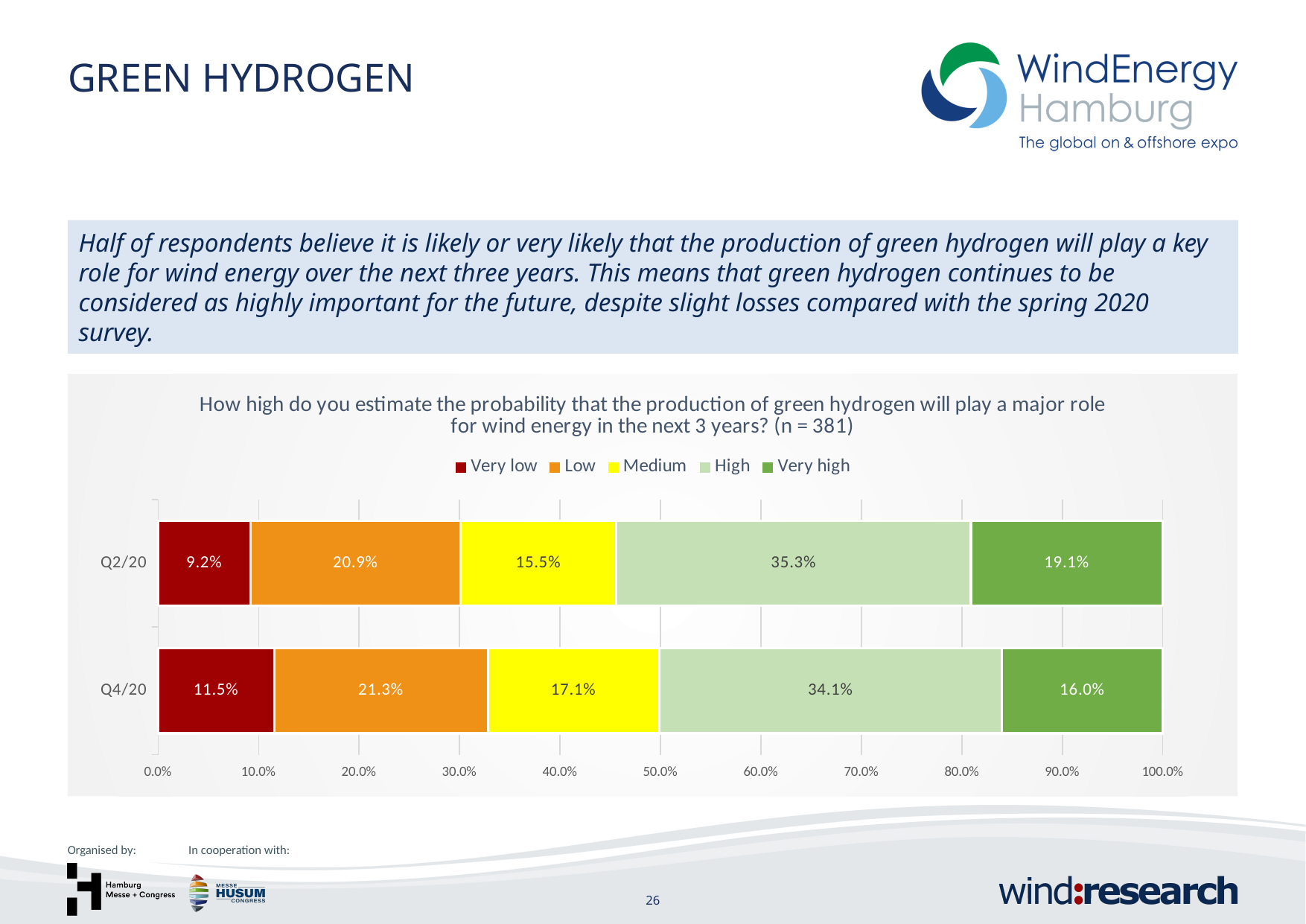
How many series does the legend list? 5 How many survey periods (bars) are shown in the chart? 2 By how many percentage points did the Very high share change from Q2/20 to Q4/20? 3.1 percentage points lower What is the Very high share for Q4/20? 16.0% What kind of chart is shown on the slide? Stacked horizontal bar chart Which response category has the largest share in the Q4/20 bar? High Which is larger: the Low share in Q2/20 or the Low share in Q4/20? Q4/20 What is the sample size (n) stated in the chart title? 381 What is the Medium share for Q2/20? 15.5% What percentage of respondents in Q4/20 rated the probability as Very low? 11.5% Which response category has the smallest share in the Q2/20 bar? Very low What percentage of respondents in Q2/20 rated the probability as High? 35.3%